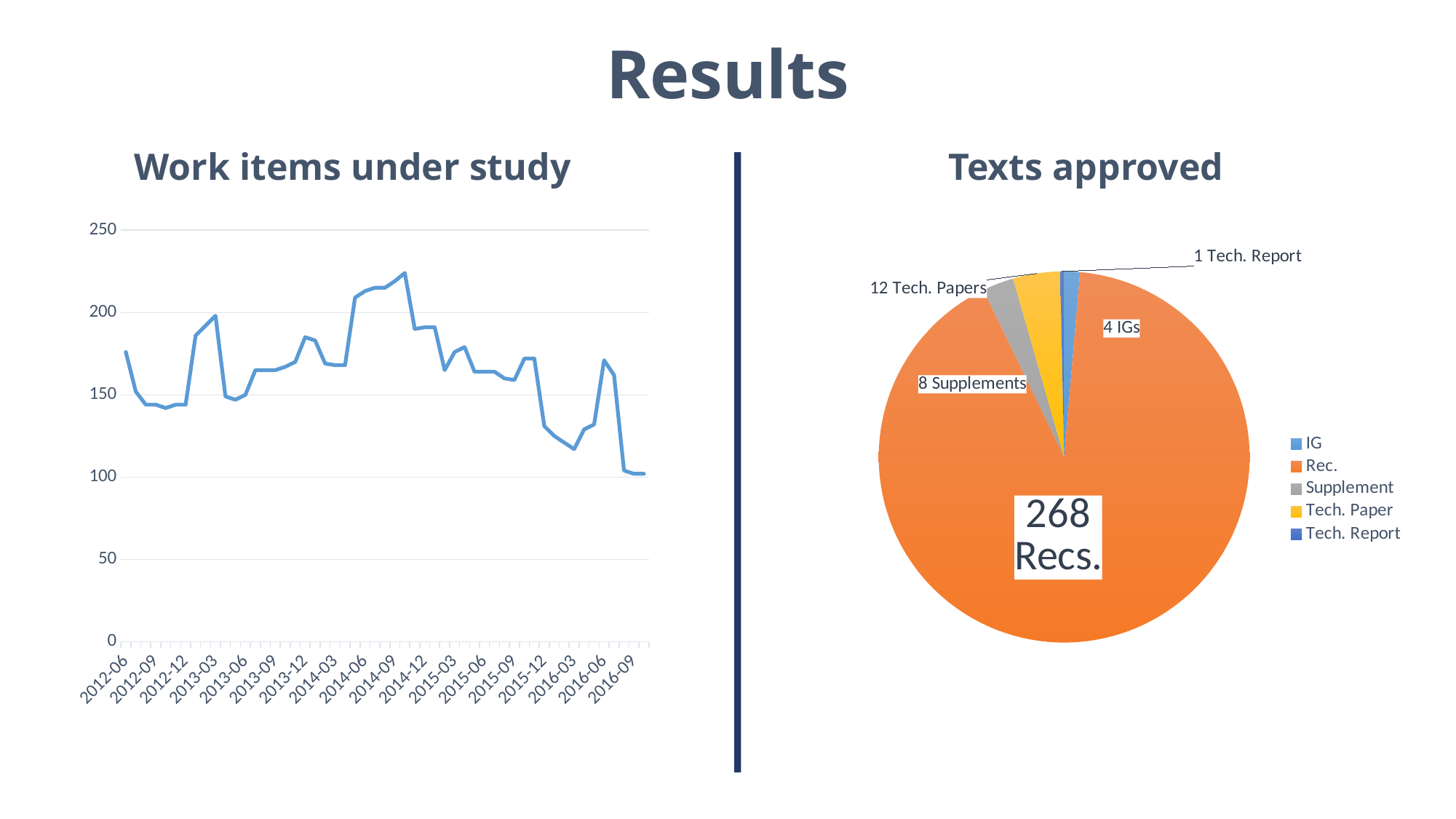
On the Texts approved pie chart, what is the total number of texts approved across all categories? 293 On the Texts approved pie chart, which category has the smallest slice? Tech. Report On the Work items under study chart, do the values overall rise or fall from 2012-06 to 2016-09? fall On the Texts approved pie chart, how many categories does the legend list? 5 On the Texts approved pie chart, how many Supplements were approved? 8 On the Work items under study chart, is the value at 2014-09 greater or less than 200? greater On the Texts approved pie chart, which category has the largest slice? Rec. What kind of chart is the Work items under study chart? Line chart On the Texts approved pie chart, how many Recs. were approved? 268 On the Texts approved pie chart, how many Tech. Papers were approved? 12 On the Texts approved pie chart, how many more Tech. Papers than IGs were approved? 8 On the Work items under study chart, is the value at 2016-09 greater or less than 150? less